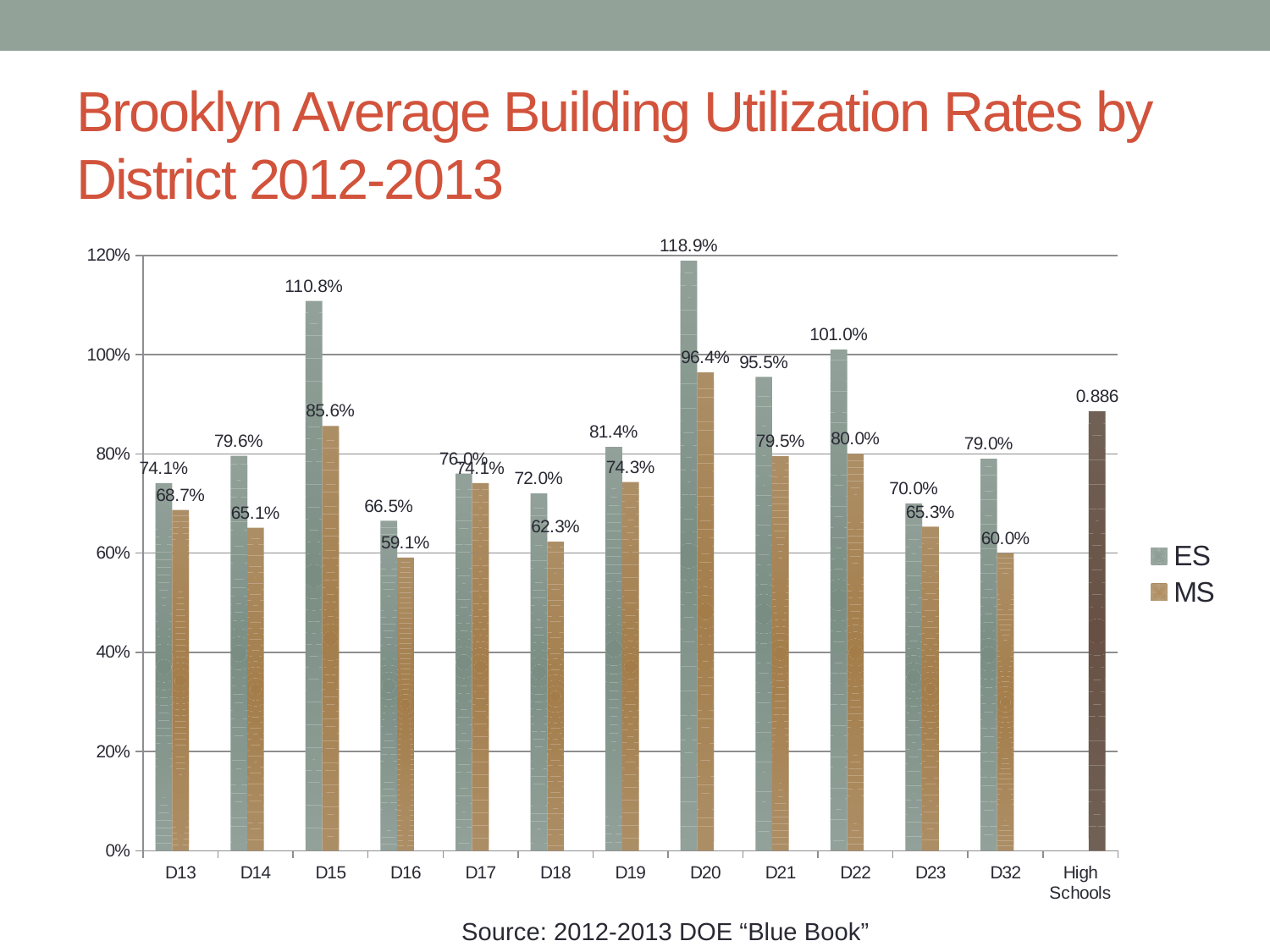
How many series does the legend list? 2 How many categories are shown on the x axis? 13 What kind of chart is shown on the slide? bar chart What is the ES value for D20? 118.9% Which is larger: the MS value for D15 or the ES value for D19? MS value for D15 What value is labeled on the High Schools bar? 0.886 What is the MS value for D15? 85.6% What is the difference between the ES and MS values for D22? 21.0% Is the ES value for D21 greater or less than 100%? less Which district has the lowest ES utilization rate? D16 Which district has the lowest MS utilization rate? D16 Which district has the highest ES utilization rate? D20